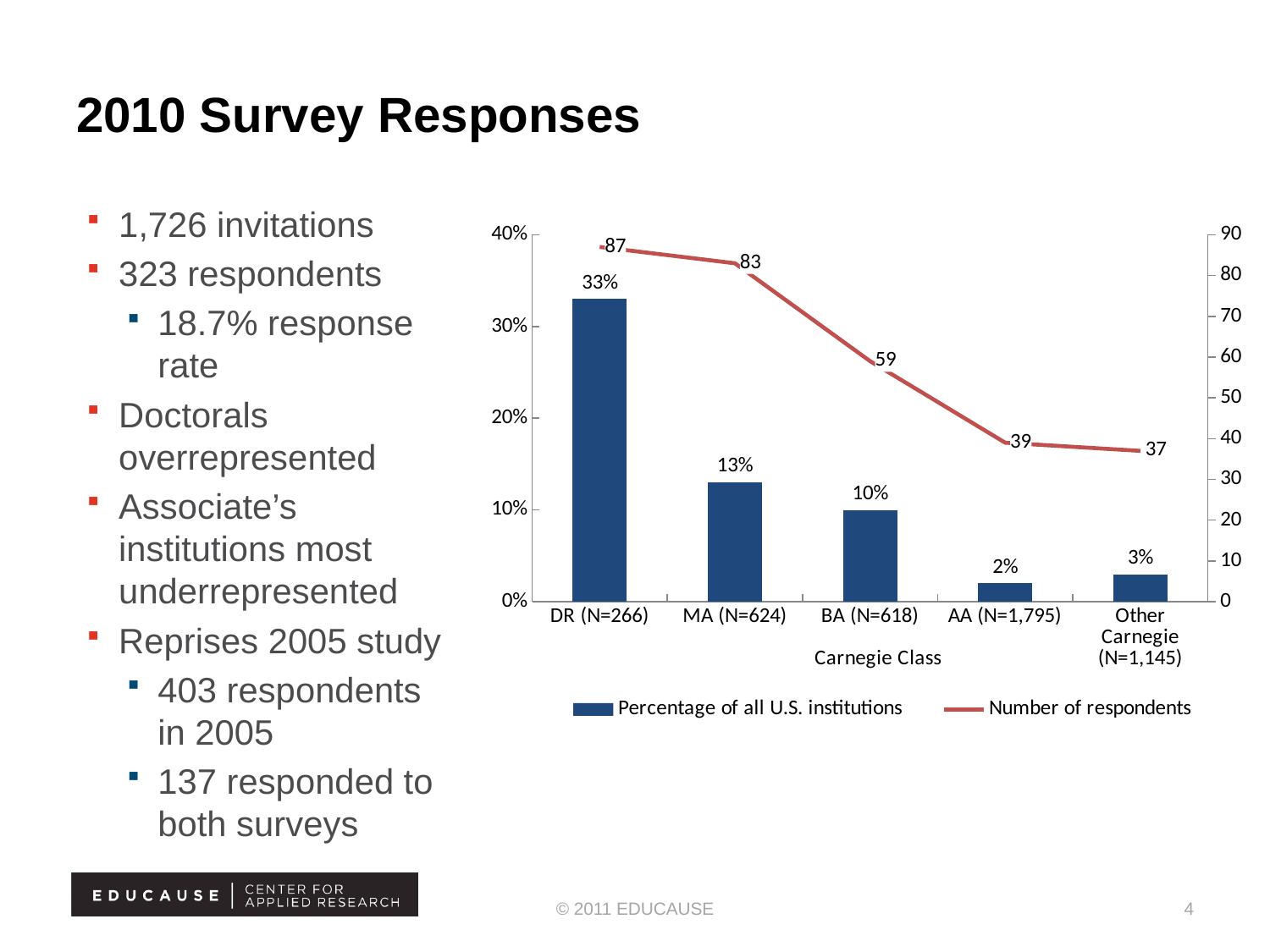
What is the difference in percentage of all U.S. institutions between MA (N=624) and BA (N=618)? 3% How many series does the legend list? 2 Which has a higher percentage of all U.S. institutions, AA (N=1,795) or Other Carnegie (N=1,145)? Other Carnegie (N=1,145) How many Carnegie classes are shown on the x axis? 5 What is the percentage of all U.S. institutions for DR (N=266)? 33% What is the difference in number of respondents between DR (N=266) and MA (N=624)? 4 What is the number of respondents for BA (N=618)? 59 Which Carnegie class has the highest percentage of all U.S. institutions? DR (N=266) Does the number of respondents rise or fall from DR (N=266) to Other Carnegie (N=1,145)? fall What is the label of the x axis? Carnegie Class What is the number of respondents for Other Carnegie (N=1,145)? 37 Which Carnegie class has the lowest number of respondents? Other Carnegie (N=1,145)